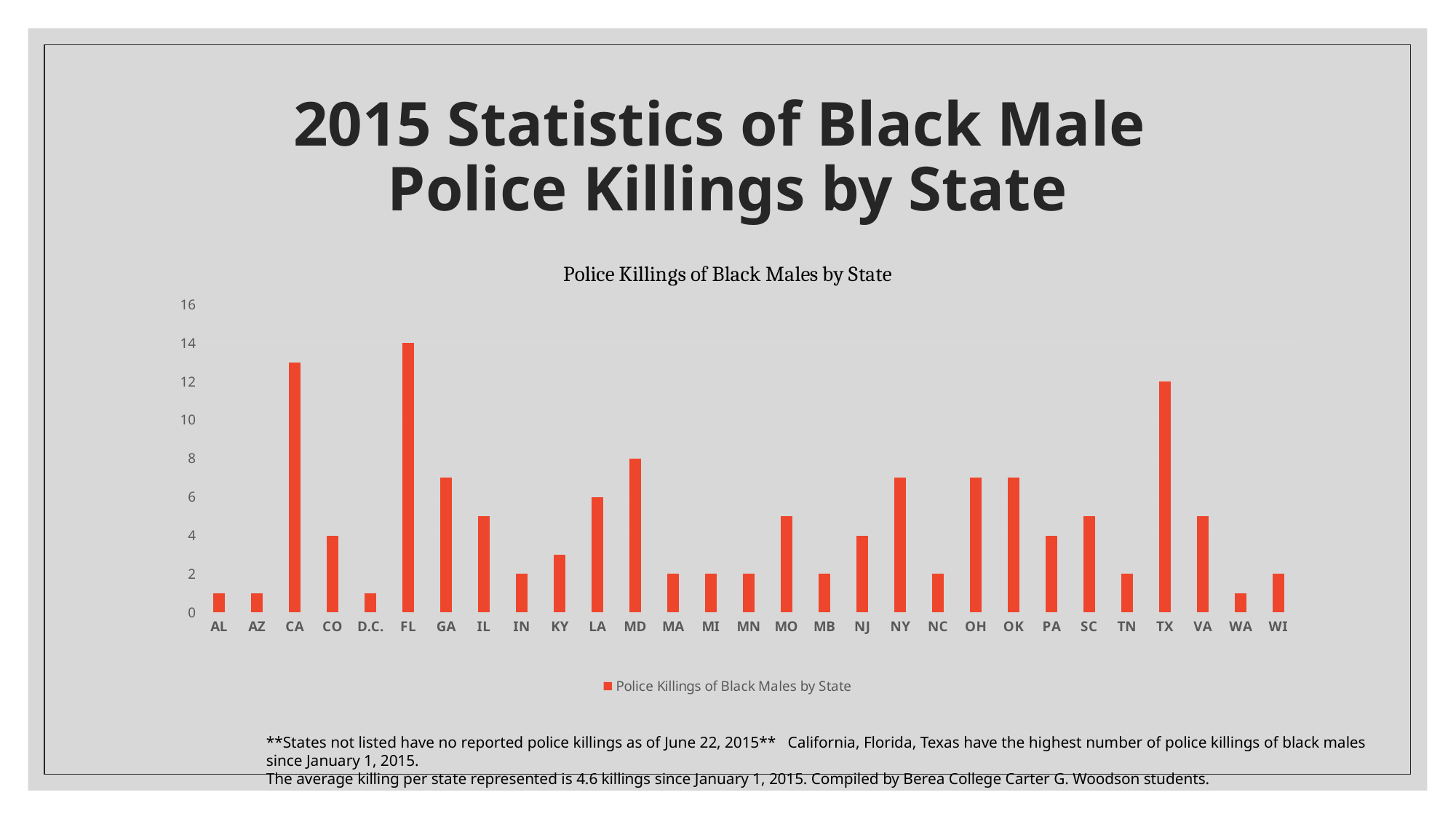
Is the value for CA greater or less than 10? greater Is the value for KY greater or less than 4? less What is the difference between the values for FL and TX? 2 How many states are shown on the x axis of the chart? 29 What is the value for TX? 12 How many series does the legend list? 1 Which state has the highest number of police killings in the chart? FL What is the title of the chart? Police Killings of Black Males by State Which is larger, the value for CA or the value for TX? CA What kind of chart is shown on the slide? bar chart What is the value for MD? 8 What is the value for FL? 14